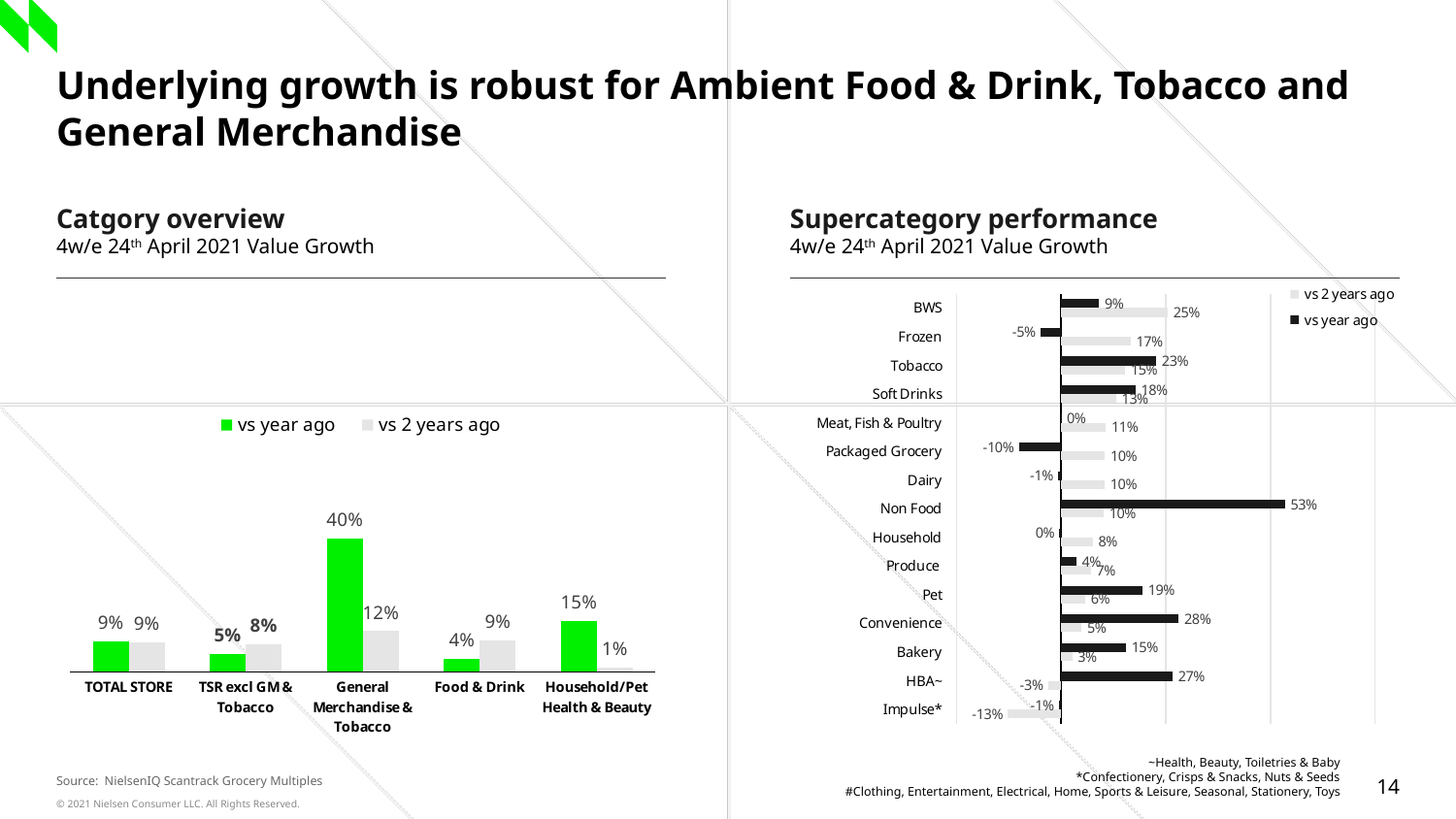
In the Supercategory performance chart, what is the difference between the vs year ago values for Convenience and Bakery? 13% In the Catgory overview chart, what kind of chart is used? Bar chart In the Catgory overview chart, what is the vs 2 years ago value for Food & Drink? 9% In the Supercategory performance chart, how many series does the legend list? 2 In the Catgory overview chart, what is the difference between the vs year ago and vs 2 years ago values for Household/Pet Health & Beauty? 14% In the Supercategory performance chart, what is the vs year ago value for Non Food? 53% In the Catgory overview chart, which category has the highest vs year ago value? General Merchandise & Tobacco In the Catgory overview chart, how many categories are shown on the x axis? 5 In the Supercategory performance chart, which supercategory has the lowest vs year ago value? Packaged Grocery In the Supercategory performance chart, what is the vs 2 years ago value for BWS? 25% In the Supercategory performance chart, which is larger for Tobacco: the vs year ago value or the vs 2 years ago value? vs year ago In the Catgory overview chart, what is the vs year ago value for General Merchandise & Tobacco? 40%